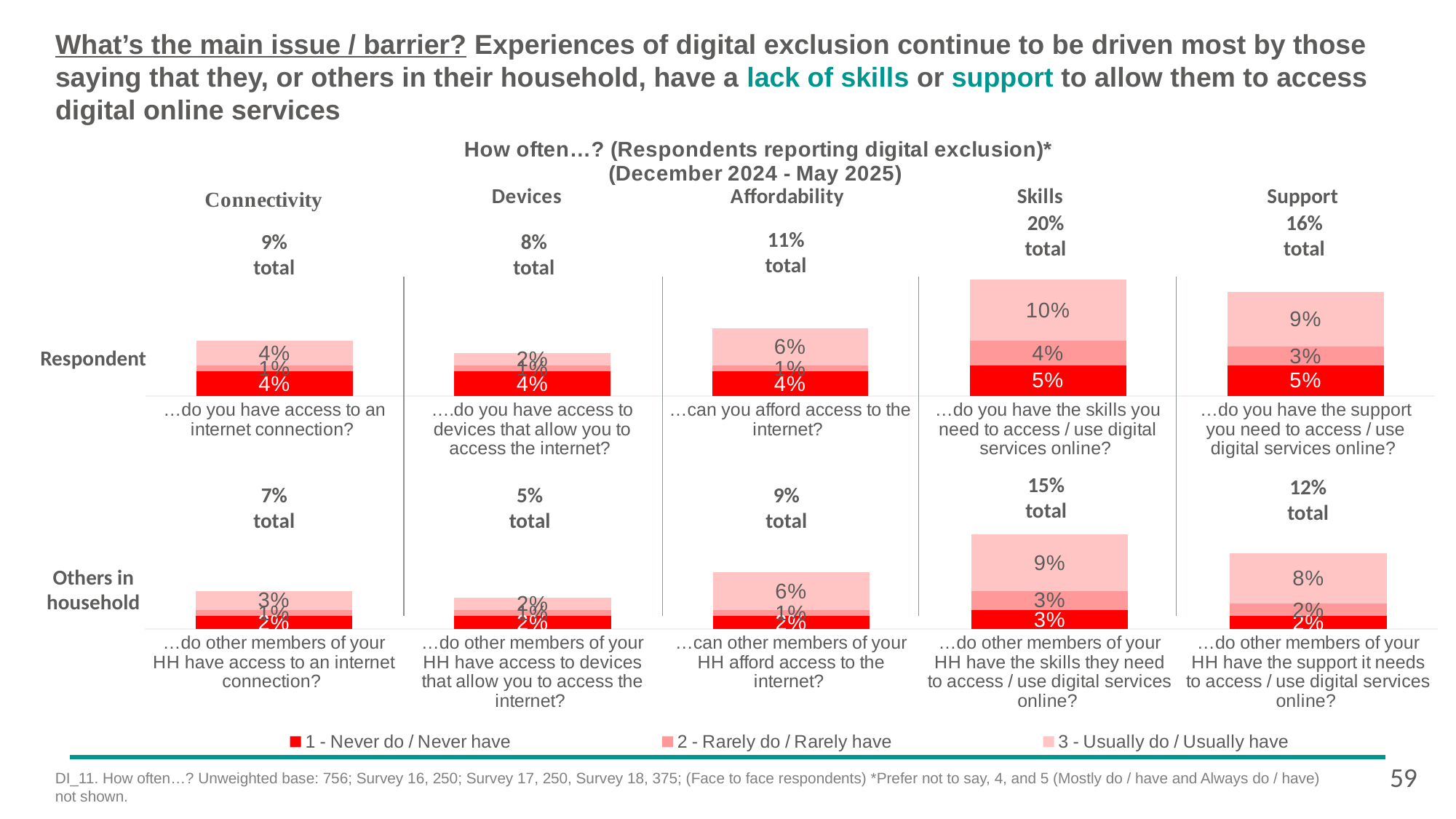
How many series does the legend list? 3 What is the difference between the Skills total for Respondent and the Skills total for Others in household? 5 percentage points In the Respondent row, which barrier has the lowest total? Devices In the Respondent row, what is the '1 - Never do / Never have' value for Support? 5% In the Respondent row, what is the total for Skills? 20% In the Others in household row, which barrier has the lowest total? Devices In the Respondent row, what is the '3 - Usually do / Usually have' value for Skills? 10% What kind of chart is shown on the slide? Stacked bar chart In the Respondent row, which barrier has the highest total? Skills In the Others in household row, what is the '3 - Usually do / Usually have' value for Affordability? 6% In the Others in household row, what is the total for Support? 12% In the Respondent row, which total is larger: Affordability or Connectivity? Affordability